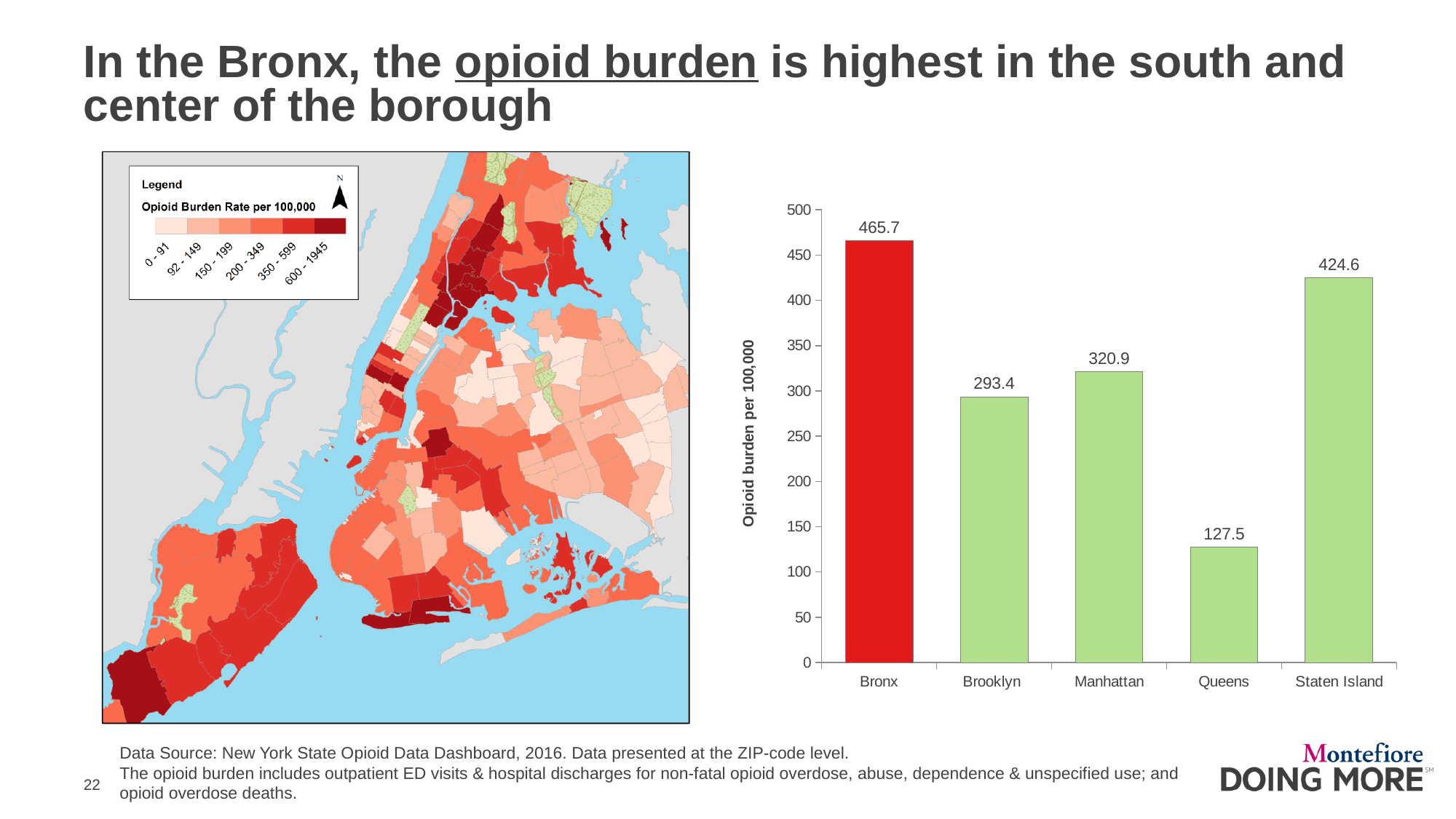
What kind of chart is shown on the right side of the slide? Bar chart In the bar chart, what is the opioid burden per 100,000 for Queens? 127.5 In the bar chart, which borough's bar is coloured red rather than green? Bronx In the bar chart, what is the opioid burden per 100,000 for Staten Island? 424.6 In the bar chart, is the value for Staten Island greater or less than 400? greater In the bar chart, which has a higher opioid burden per 100,000, Brooklyn or Manhattan? Manhattan In the bar chart, what is the difference between the opioid burden for Manhattan and for Brooklyn? 27.5 How many boroughs are shown in the bar chart? 5 In the bar chart, which borough has the highest opioid burden per 100,000? Bronx In the bar chart, which borough has the lowest opioid burden per 100,000? Queens In the bar chart, what is the opioid burden per 100,000 for the Bronx? 465.7 In the bar chart, what is the difference between the opioid burden for the Bronx and for Staten Island? 41.1